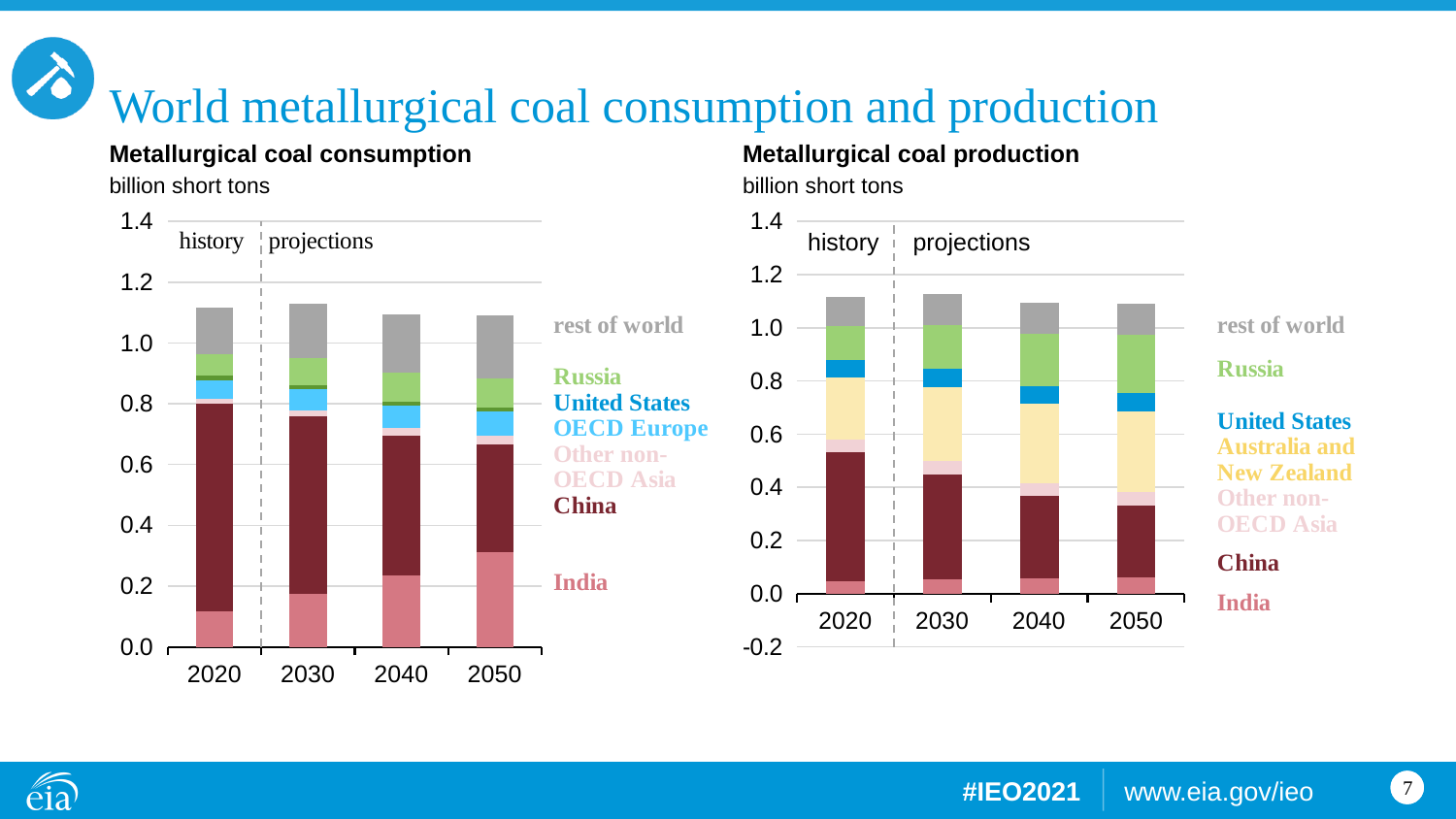
In the Metallurgical coal consumption chart, does the China segment rise or fall from 2020 to 2050? fall How many series are labelled on the Metallurgical coal production chart? 7 How many series are labelled on the Metallurgical coal consumption chart? 7 In the Metallurgical coal consumption chart, is the India segment for 2050 greater or less than 0.2? greater In the Metallurgical coal production chart, is the India segment for 2020 greater or less than 0.2? less In the Metallurgical coal consumption chart, is the total stacked bar for 2020 greater or less than 1.0? greater What kind of chart is the Metallurgical coal consumption chart? stacked bar chart How many years are shown on the x axis of the Metallurgical coal consumption chart? 4 What unit is used on the y axis of both charts? billion short tons In the Metallurgical coal consumption chart, does the India segment rise or fall from 2020 to 2050? rise In the Metallurgical coal production chart, does the China segment rise or fall from 2020 to 2050? fall